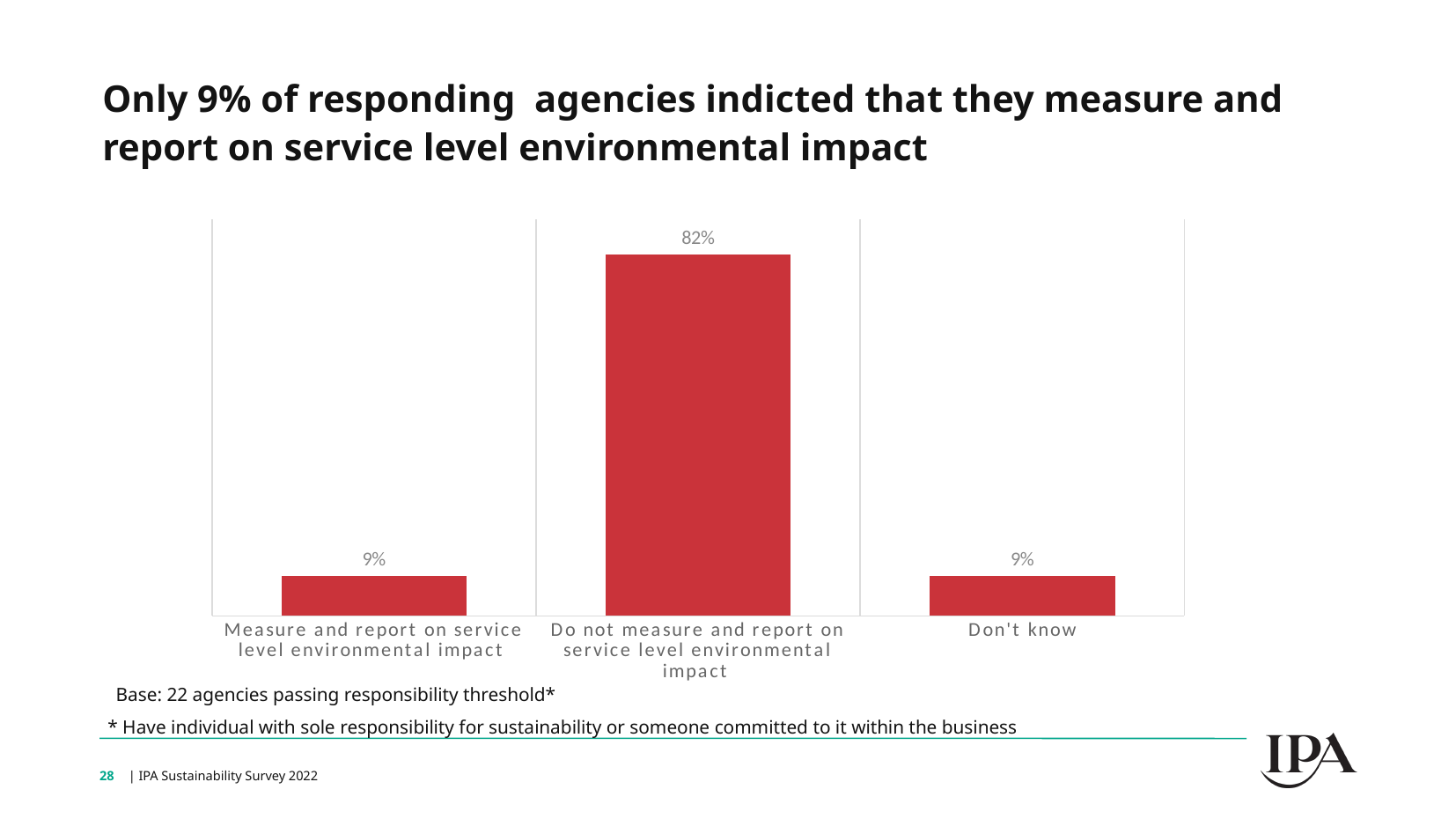
What is the difference between the 'Do not measure and report' value and the 'Measure and report' value? 73 percentage points Which category has the highest value? Do not measure and report on service level environmental impact Which is larger: the value for 'Do not measure and report on service level environmental impact' or the value for 'Don't know'? Do not measure and report on service level environmental impact How many categories are shown in the chart? 3 What percentage of agencies measure and report on service level environmental impact? 9% What percentage of agencies do not measure and report on service level environmental impact? 82% What colour are the bars in the chart? Red What is the base (number of agencies) for the chart? 22 agencies passing responsibility threshold What kind of chart is shown on the slide? Bar chart Do the 'Measure and report' and 'Don't know' categories have the same value? Yes, both 9% What percentage of agencies answered 'Don't know'? 9%